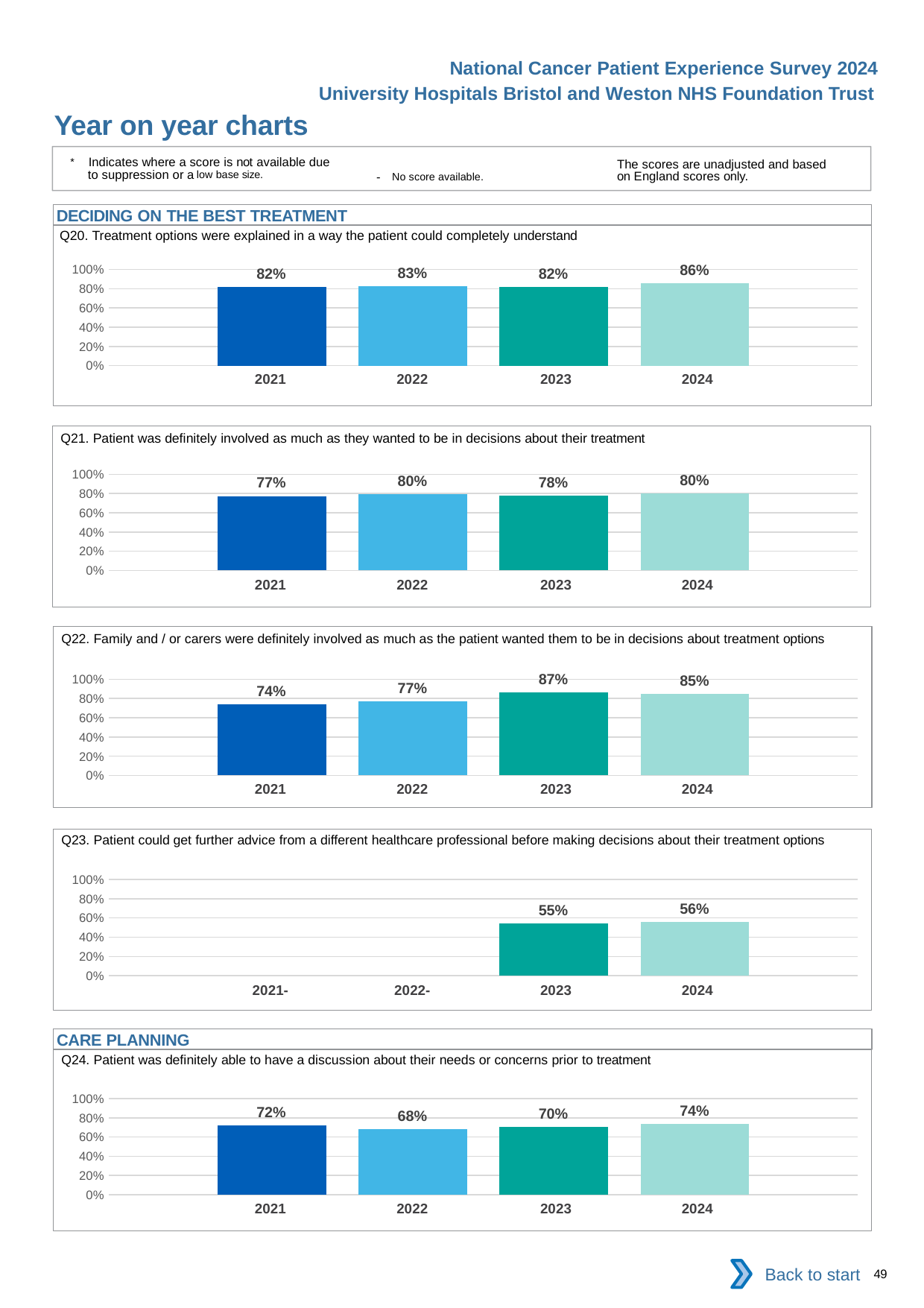
In the Q20 chart, which year has the highest value? 2024 In the Q22 chart, what is the difference between the 2023 and 2021 values? 13 percentage points In the Q21 chart, what is the value for 2021? 77% In the Q23 chart, how many years have a bar plotted? 2 How many charts are shown on the slide? 5 In the Q21 chart, what is the difference between the 2022 and 2021 values? 3 percentage points In the Q24 chart, which year has the lowest value? 2022 In the Q22 chart, which year has the lowest value? 2021 What kind of chart is used for Q24? bar chart In the Q20 chart, what is the value for 2024? 86% In the Q23 chart, what is the value for 2023? 55% In the Q24 chart, is the value for 2024 larger or smaller than the value for 2023? larger